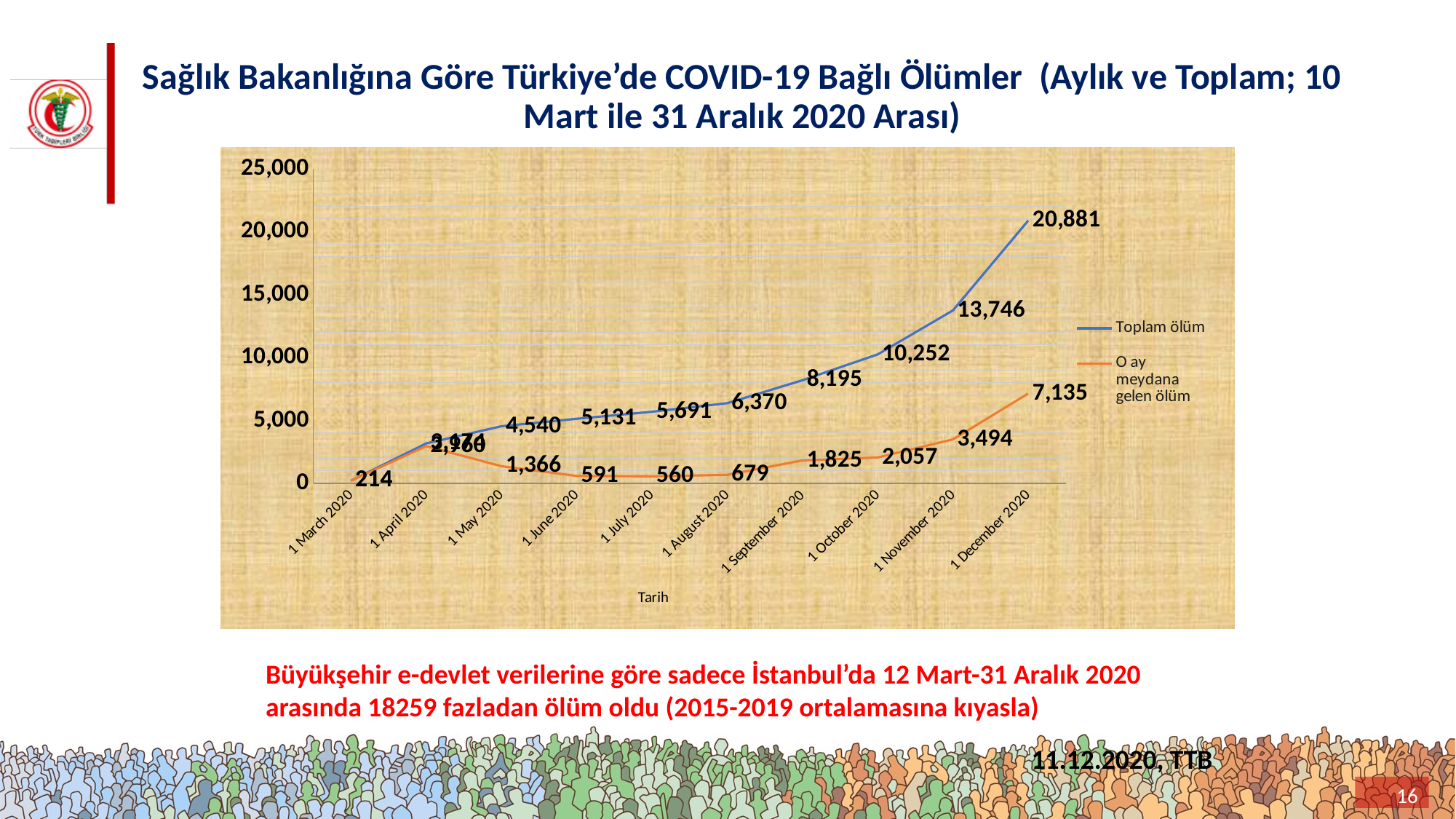
What kind of chart is shown on the slide? Line chart What is the value of Toplam ölüm on 1 October 2020? 10,252 How many dates are plotted on the x axis? 10 What is the difference between O ay meydana gelen ölüm on 1 November 2020 and on 1 October 2020? 1,437 What is the value of O ay meydana gelen ölüm on 1 July 2020? 560 What is the difference between Toplam ölüm on 1 December 2020 and on 1 November 2020? 7,135 Which is larger for O ay meydana gelen ölüm: 1 June 2020 or 1 August 2020? 1 August 2020 On which date is Toplam ölüm highest? 1 December 2020 What is the value of Toplam ölüm on 1 December 2020? 20,881 How many series does the legend list? 2 On which date is O ay meydana gelen ölüm lowest? 1 March 2020 What is the value of O ay meydana gelen ölüm on 1 December 2020? 7,135